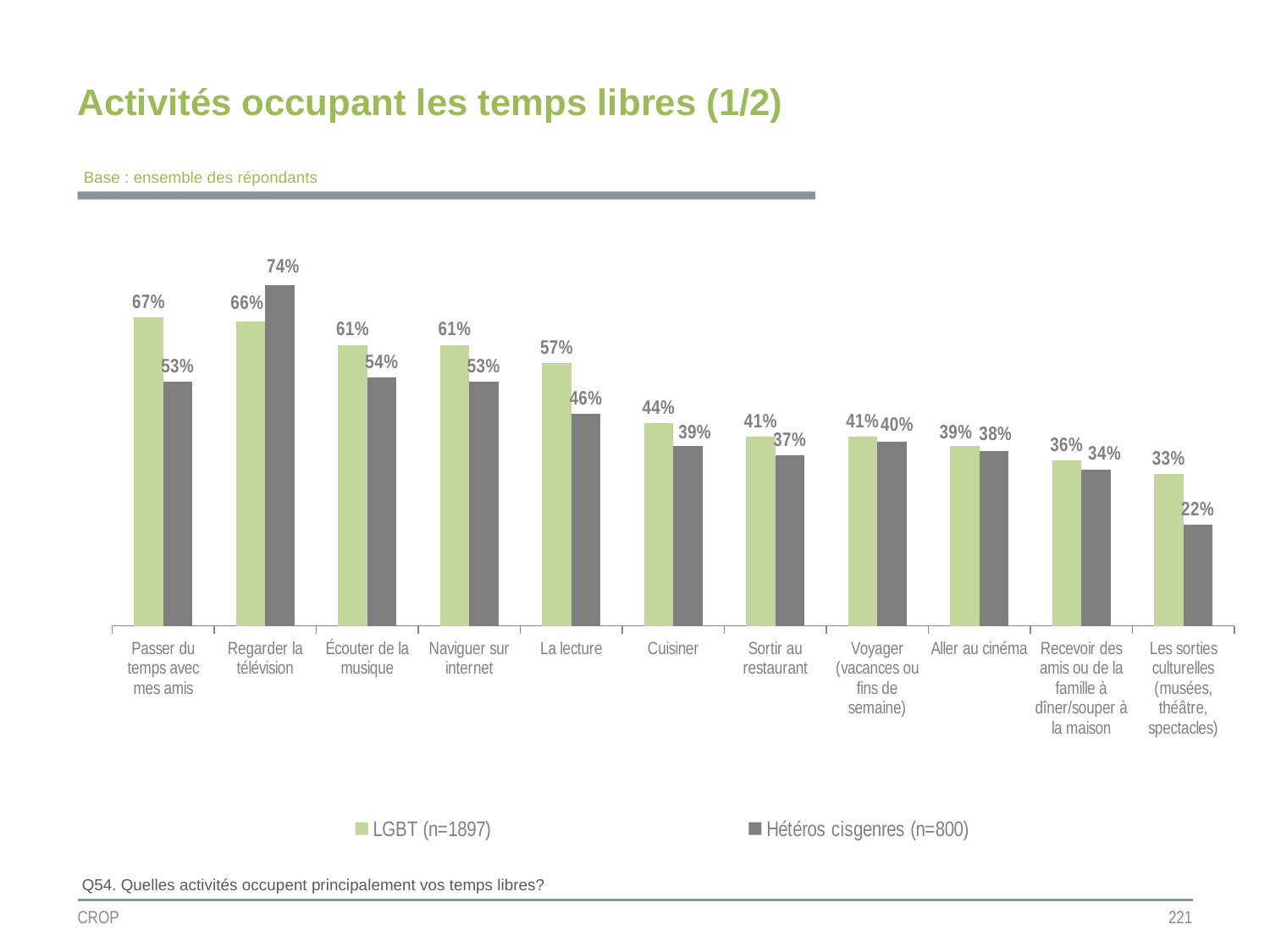
What is the value for LGBT (n=1897) for "Regarder la télévision"? 66% For "Regarder la télévision", which series has the larger value, LGBT (n=1897) or Hétéros cisgenres (n=800)? Hétéros cisgenres (n=800) How many activity categories are shown on the chart? 11 What is the base stated for the chart? Ensemble des répondants Which category has the lowest value for LGBT (n=1897)? Les sorties culturelles (musées, théâtre, spectacles) What is the value for Hétéros cisgenres (n=800) for "Les sorties culturelles (musées, théâtre, spectacles)"? 22% What is the difference between the LGBT (n=1897) and Hétéros cisgenres (n=800) values for "Passer du temps avec mes amis"? 14 percentage points How many series does the legend list? 2 Do the LGBT (n=1897) values generally rise or fall from left to right across the categories? Fall Which category has the highest value for Hétéros cisgenres (n=800)? Regarder la télévision What kind of chart is shown on the slide? Bar chart What is the value for Hétéros cisgenres (n=800) for "La lecture"? 46%